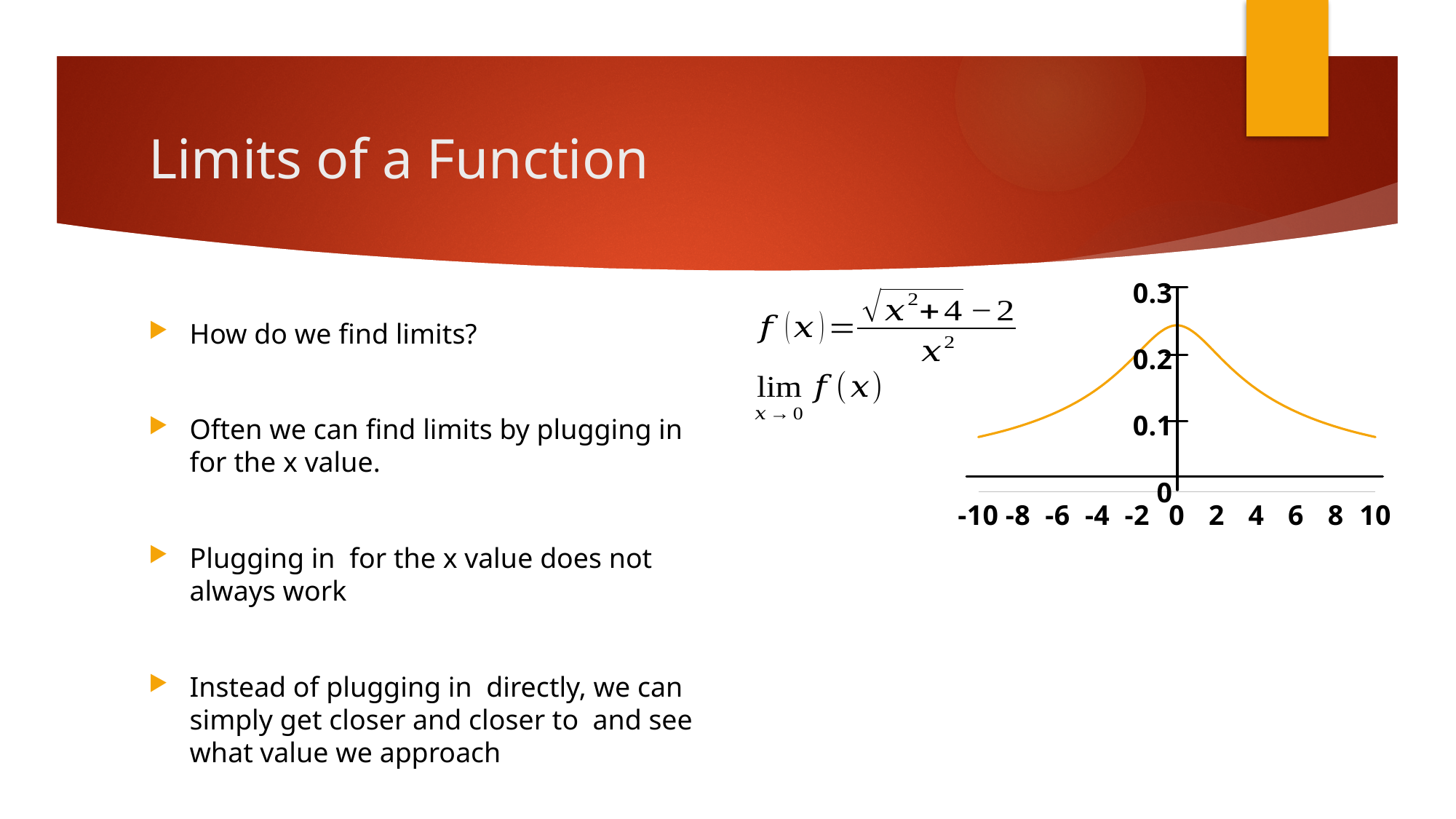
At which x value does the plotted curve reach its highest point? 0 Is the value of the curve at x = 0 greater or less than 0.2? greater Which is larger, the value of the curve at x = 0 or at x = 8? x = 0 What kind of chart is shown on the slide? line chart How many tick labels are shown on the x axis? 11 Is the value of the curve at x = -10 greater or less than 0.2? less What is the highest tick label shown on the y axis? 0.3 Does the curve rise or fall as x goes from 0 to 10? fall Is the value of the curve at x = 0 greater or less than 0.3? less Does the curve rise or fall as x goes from -10 to 0? rise